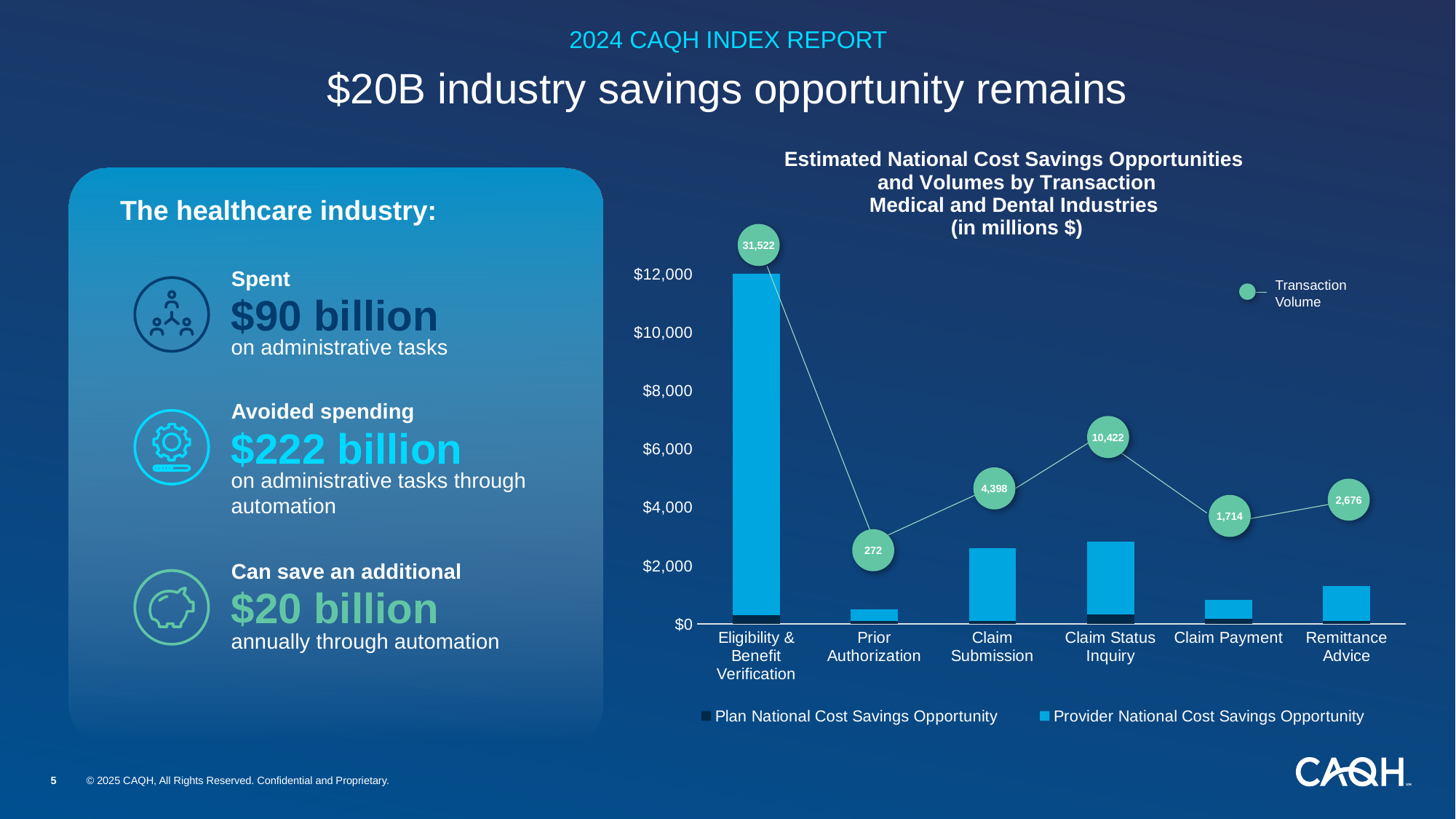
Which has a larger transaction volume, Remittance Advice or Claim Payment? Remittance Advice Which transaction has the tallest cost savings bar? Eligibility & Benefit Verification Is the total cost savings bar for Remittance Advice greater or less than $2,000? less Which transaction has the highest transaction volume? Eligibility & Benefit Verification How many transaction categories are shown on the x axis of the chart? 6 Is the total cost savings bar for Claim Status Inquiry greater or less than $2,000? greater What is the transaction volume shown for Claim Status Inquiry? 10,422 How many series does the legend at the bottom of the chart list? 2 What is the transaction volume shown for Prior Authorization? 272 Which transaction has the lowest transaction volume? Prior Authorization What is the transaction volume shown for Eligibility & Benefit Verification? 31,522 What is the difference in transaction volume between Claim Status Inquiry and Claim Submission? 6,024